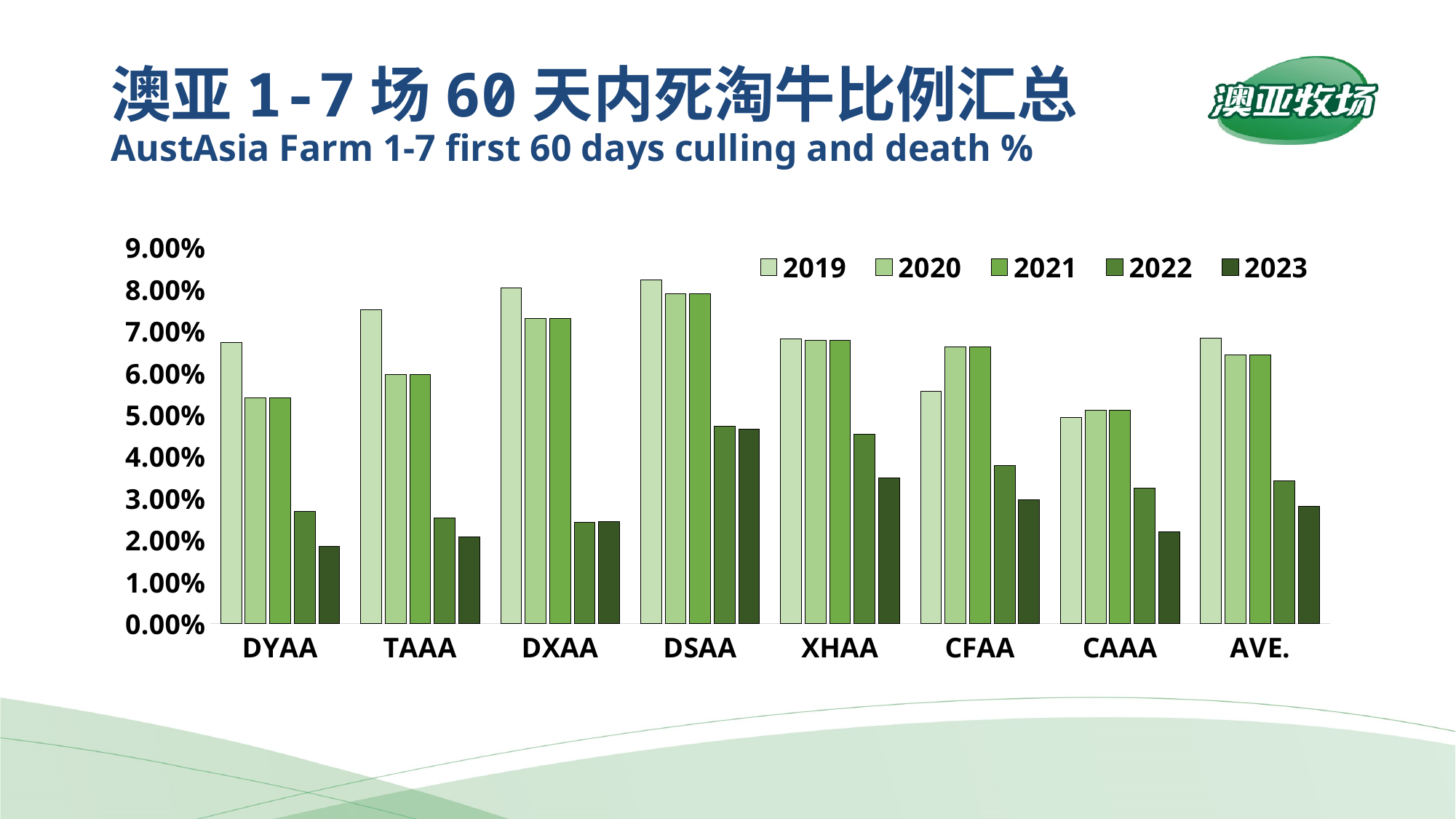
Is the 2022 value for DYAA greater or less than 3.00%? less Which farm has the lowest 2019 value? CAAA For DYAA, do the values rise or fall from 2019 to 2023? fall What kind of chart is shown on the slide? bar chart Which years are listed in the chart legend? 2019, 2020, 2021, 2022, 2023 Is the 2019 value for CFAA greater or less than 5.00%? greater Which is larger, the 2022 value for DSAA or the 2022 value for CAAA? DSAA Which is larger for CFAA, the 2019 value or the 2020 value? 2020 Is the 2019 value for DSAA greater or less than 8.00%? greater How many series does the chart legend list? 5 Which farm has the highest 2023 value? DSAA How many farm categories are shown on the x axis of the chart? 8